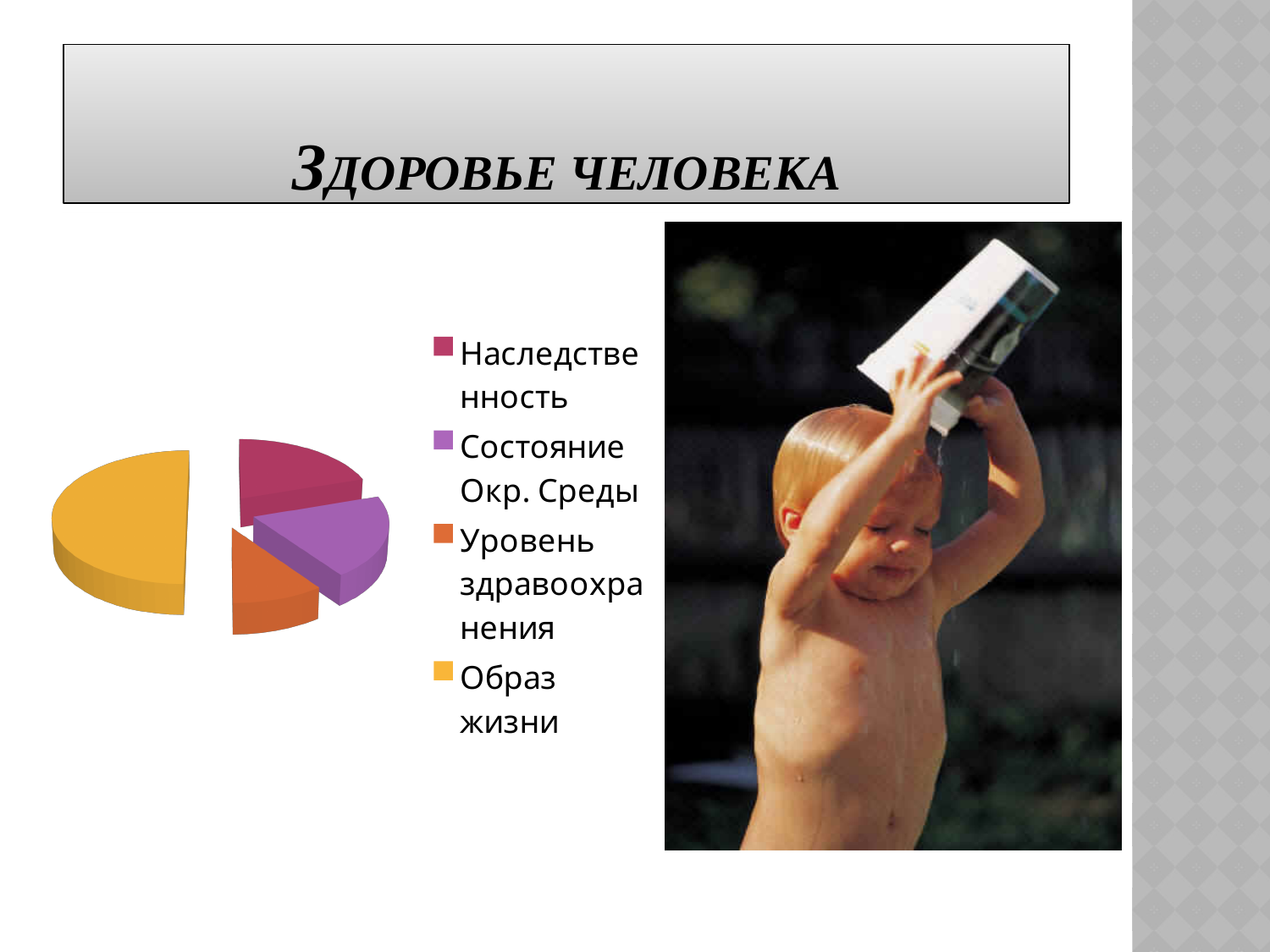
What is the title of the slide containing the pie chart? Здоровье человека Which category has the largest slice in the pie chart? Образ жизни What kind of chart is shown on the slide? pie chart Which slice is larger: Образ жизни or Уровень здравоохранения? Образ жизни What colour is the slice for Образ жизни? yellow Which slice is larger: Образ жизни or Наследственность? Образ жизни Which slice is larger: Образ жизни or Состояние Окр. Среды? Образ жизни How many slices does the pie chart have? 4